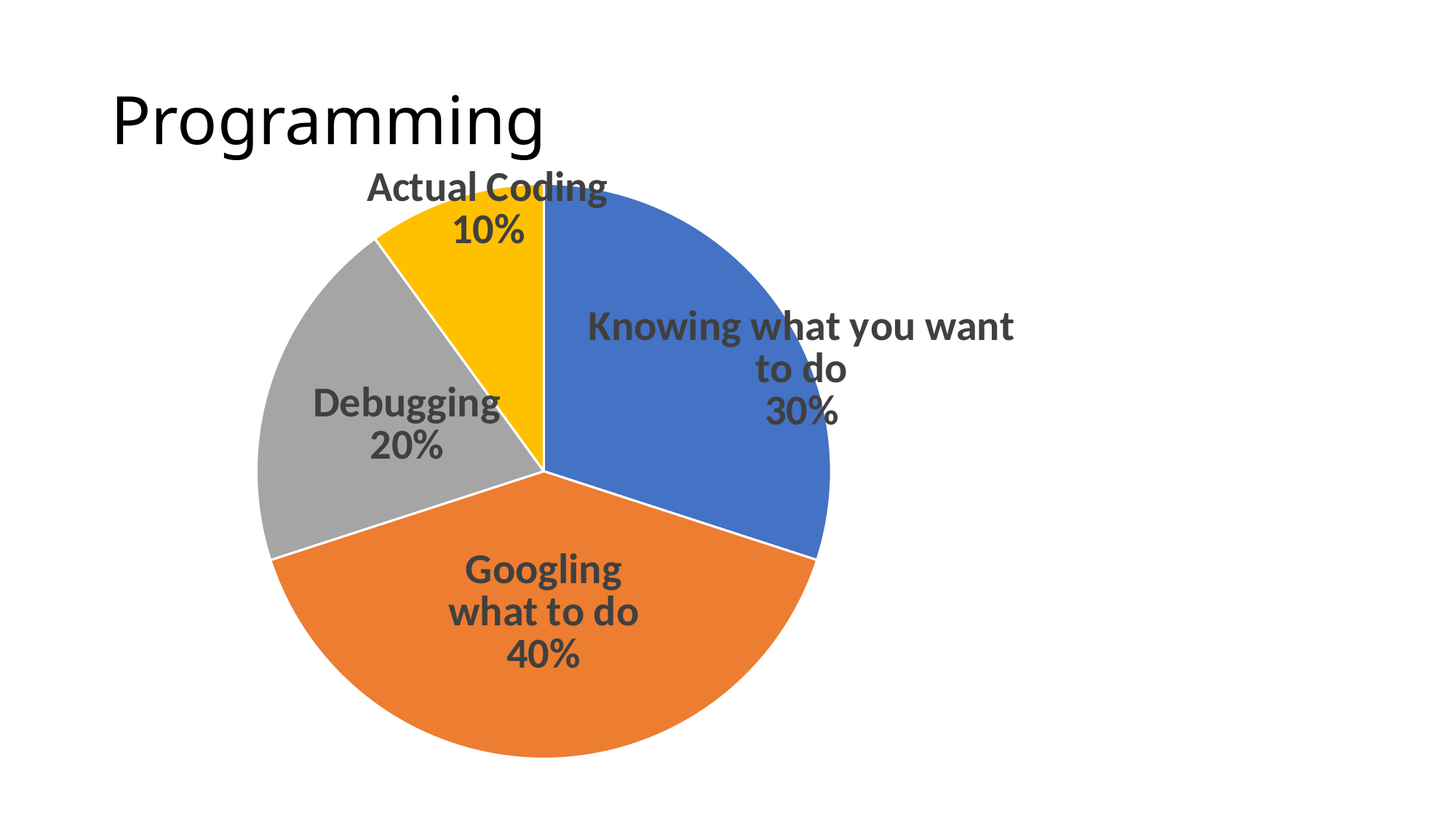
What percentage is shown for Actual Coding? 10% What colour is the Debugging slice? Grey What kind of chart is shown on the slide? Pie chart How many slices does the pie chart have? 4 What is the title of the slide? Programming Which is larger, Debugging or Knowing what you want to do? Knowing what you want to do Which slice of the pie is the smallest? Actual Coding What percentage is shown for Debugging? 20% What percentage is shown for Googling what to do? 40% What is the difference in percentage points between Googling what to do and Actual Coding? 30 Which slice of the pie is the largest? Googling what to do What percentage is shown for Knowing what you want to do? 30%